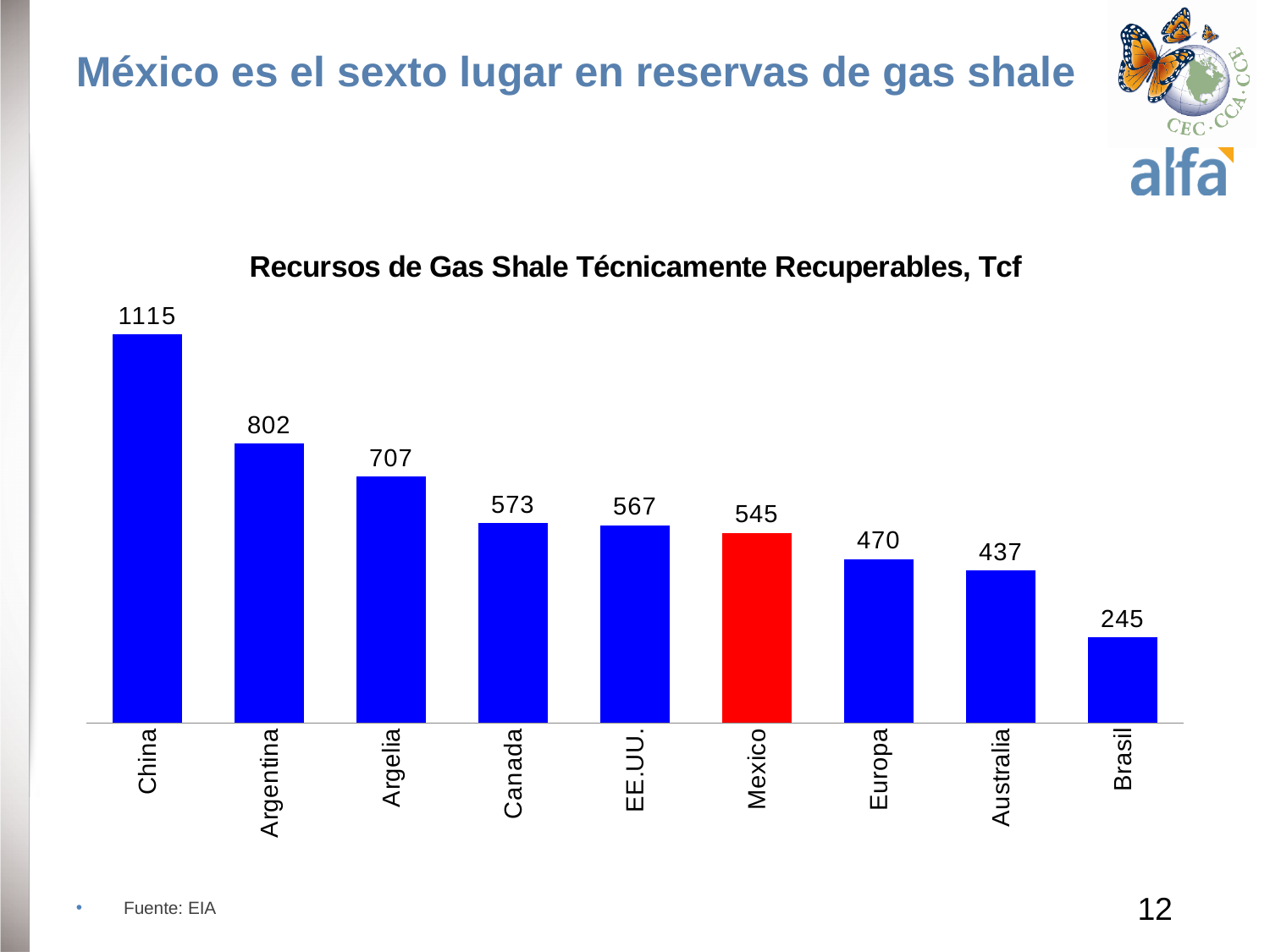
What is the difference between the values for China and Argentina? 313 How many categories are shown on the chart? 9 Do the values rise or fall from left to right along the x axis? fall What is the value for Brasil? 245 Which category has the highest value? China What is the difference between the values for EE.UU. and Mexico? 22 What is the value for Mexico? 545 What kind of chart is shown on the slide? bar chart Which category has the lowest value? Brasil What is the value for Argentina? 802 What is the title of the chart? Recursos de Gas Shale Técnicamente Recuperables, Tcf Which is larger, the value for Canada or the value for Europa? Canada